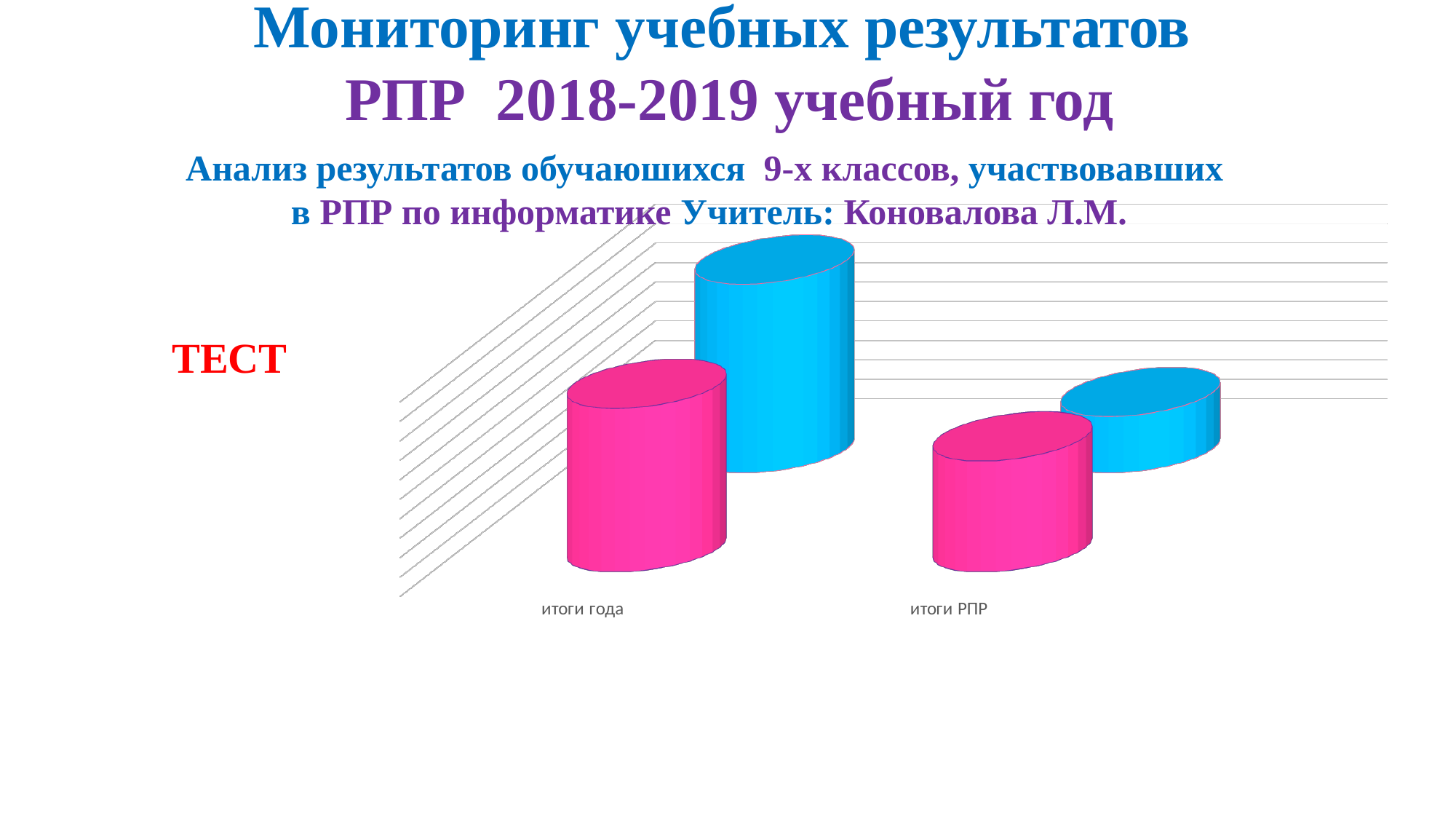
For the blue series, which category has the higher value: итоги года or итоги РПР? итоги года Do the values of the blue series rise or fall from итоги года to итоги РПР? fall Do the values of the pink series rise or fall from итоги года to итоги РПР? fall What are the two category labels on the x axis of the chart? итоги года, итоги РПР Which category has the tallest bar in the chart? итоги года How many bars are plotted for each category in the chart? 2 How many categories are shown on the x axis of the chart? 2 What kind of chart is shown on the slide? bar chart In the итоги года category, which bar is taller: the pink one or the blue one? the blue one What two colours are used for the bars in the chart? pink and blue For the pink series, which category has the higher value: итоги года or итоги РПР? итоги года